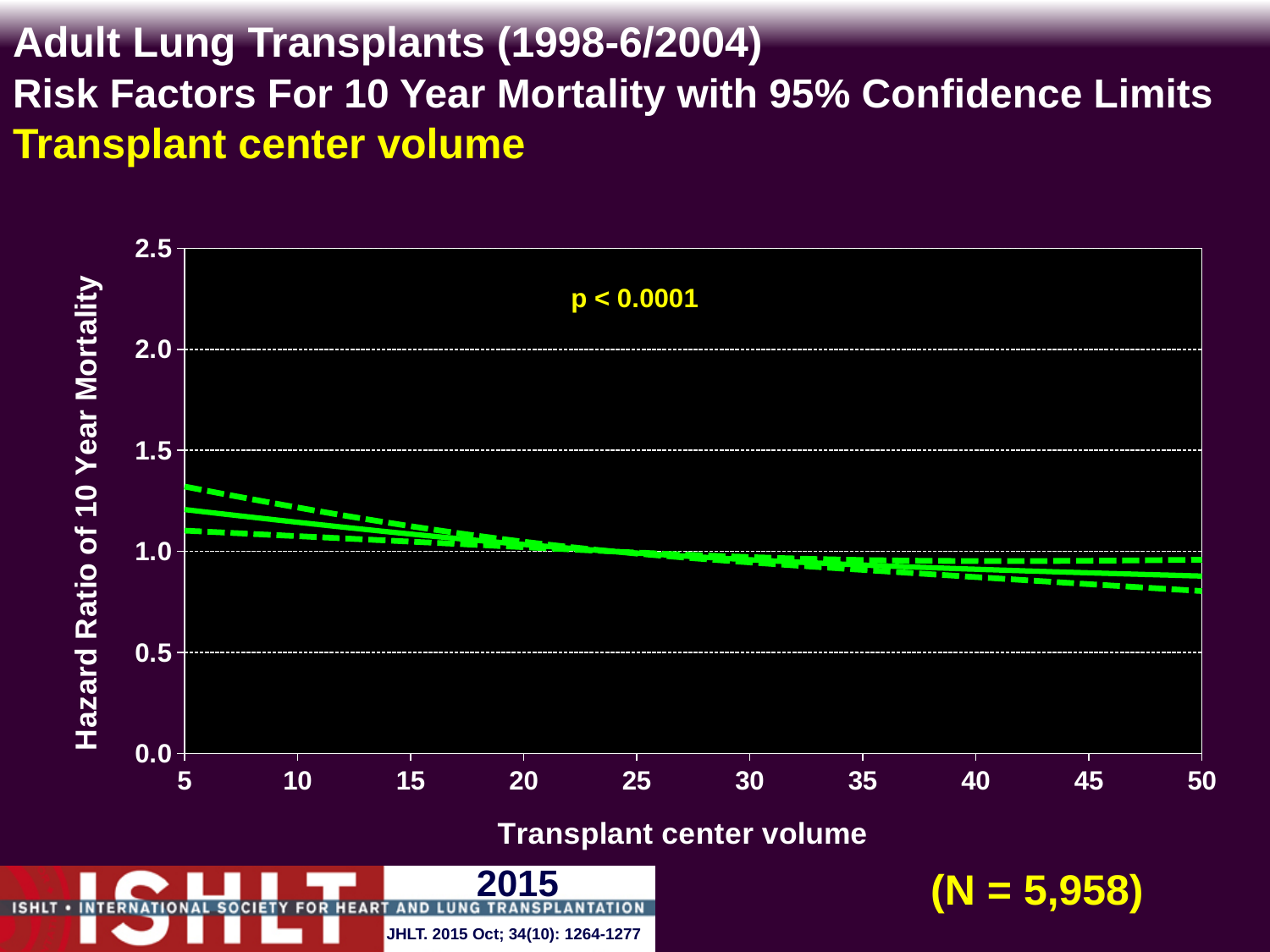
Is the hazard ratio (solid line) at a transplant center volume of 50 greater or less than 1.0? less How many lines are plotted on the chart? 3 What is the highest value shown on the y axis of the chart? 2.5 What is the sample size (N) shown on the slide? 5,958 Is the hazard ratio (solid line) at a transplant center volume of 5 greater or less than 1.0? greater What kind of chart is shown on the slide? Line chart Is the lower 95% confidence limit at a transplant center volume of 50 greater or less than 0.5? greater What p-value is printed on the chart? p < 0.0001 Does the hazard ratio of 10 year mortality rise or fall as transplant center volume increases from 5 to 50? Fall Is the hazard ratio at a transplant center volume of 5 larger or smaller than at a volume of 50? Larger What is the label of the x axis? Transplant center volume